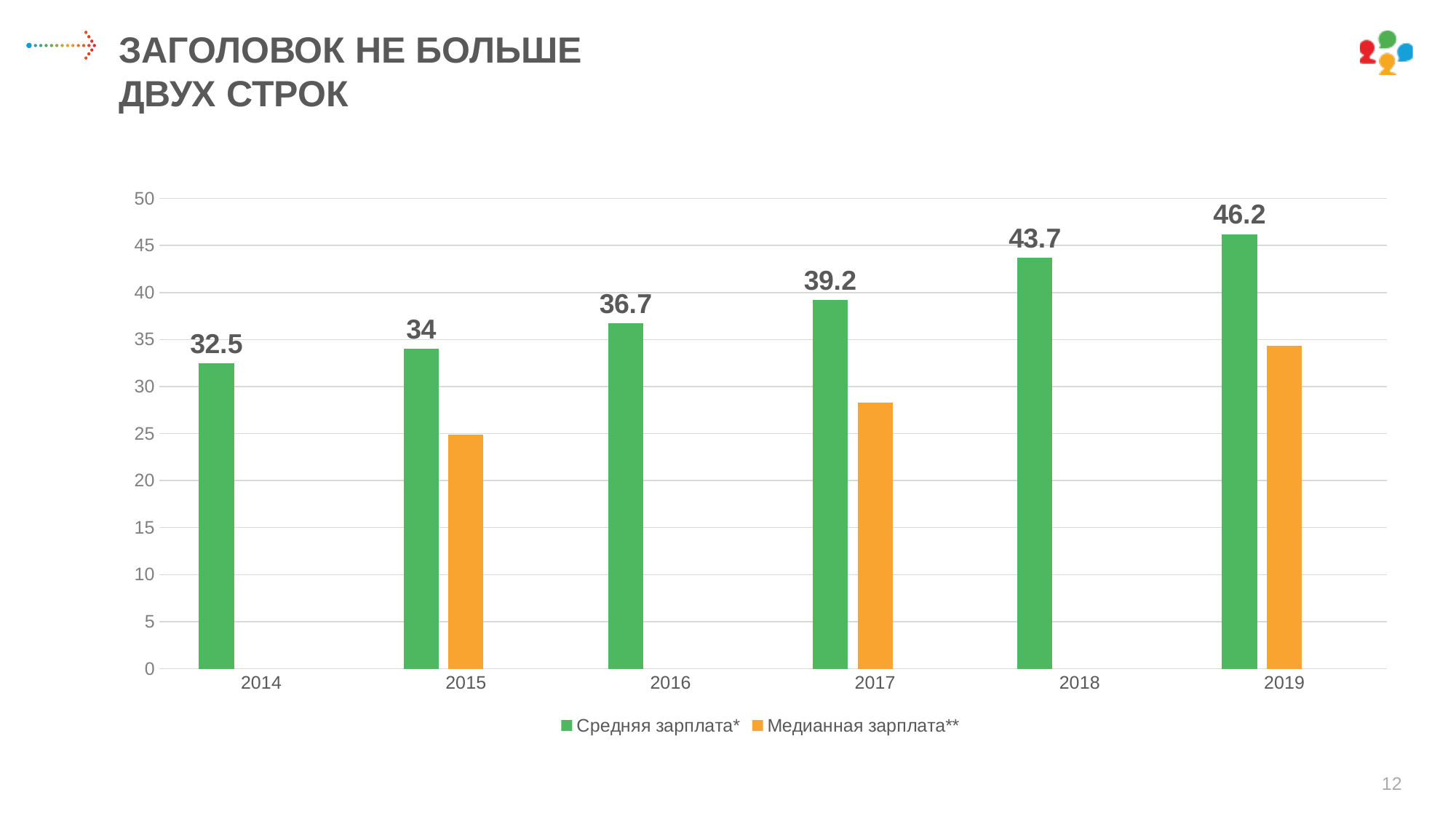
Which year has the lowest Средняя зарплата*? 2014 How many years are shown on the x axis? 6 Is the value of Медианная зарплата** for 2019 greater or less than 30? greater Which year has the highest Средняя зарплата*? 2019 Which is larger: Средняя зарплата* in 2016 or in 2018? 2018 What is the value of Средняя зарплата* for 2017? 39.2 What kind of chart is shown on the slide? Bar chart What is the value of Средняя зарплата* for 2019? 46.2 Is the value of Медианная зарплата** for 2015 greater or less than 30? less What is the difference between Средняя зарплата* in 2019 and in 2014? 13.7 What is the value of Средняя зарплата* for 2014? 32.5 How many series does the legend list? 2